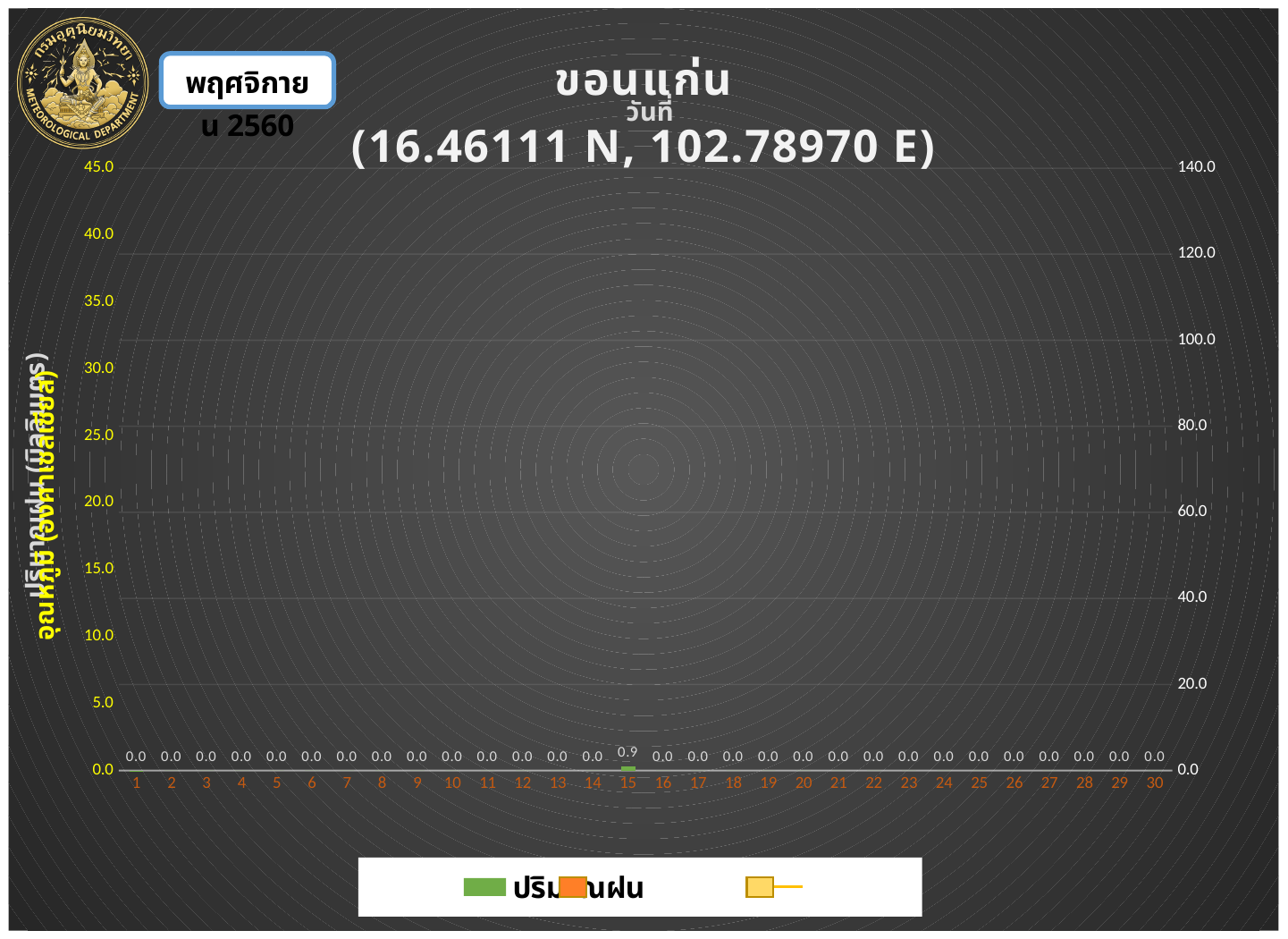
What is the highest tick value on the right vertical axis? 140.0 What is the difference between the rainfall values for day 15 and day 14? 0.9 Is the rainfall value for day 15 greater or less than 5.0? less What is the rainfall value shown for day 15? 0.9 What is the highest tick value on the left vertical axis? 45.0 What is the total of the rainfall values shown for days 1 through 30? 0.9 What is the rainfall value shown for day 30? 0.0 How many days are shown on the x axis? 30 What is the rainfall value shown for day 1? 0.0 What kind of chart is this? Bar chart Which day has the highest rainfall value? 15 Which is larger, the rainfall value for day 15 or for day 16? Day 15